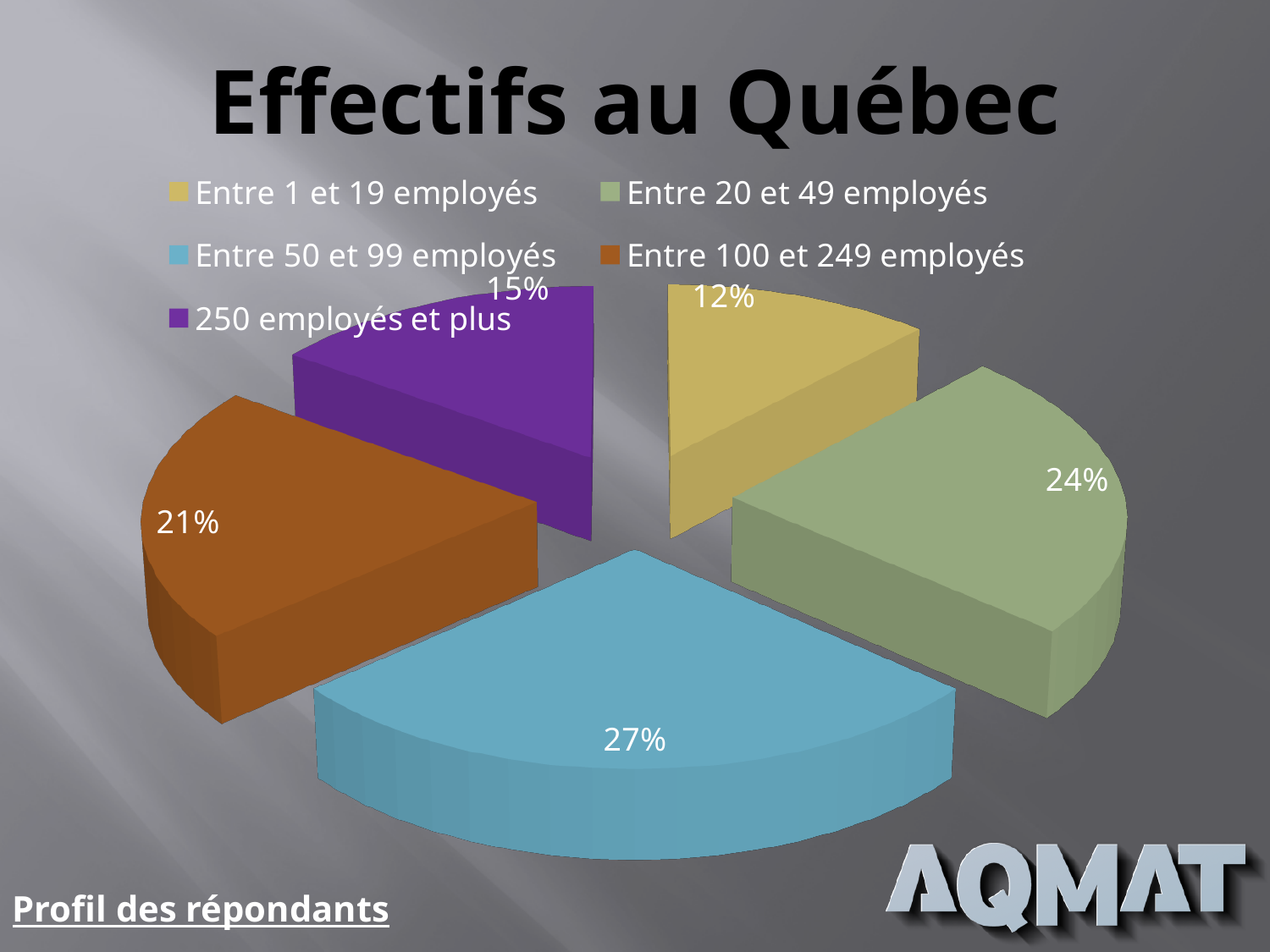
What share of the pie is '250 employés et plus'? 15% What kind of chart is shown on the slide? Pie chart Which category has the largest share of the pie? Entre 50 et 99 employés What share of the pie is 'Entre 50 et 99 employés'? 27% How many categories does the legend list? 5 What is the title of the chart? Effectifs au Québec What share of the pie is 'Entre 20 et 49 employés'? 24% What share of the pie is 'Entre 100 et 249 employés'? 21% Which is larger, the share for 'Entre 100 et 249 employés' or the share for '250 employés et plus'? Entre 100 et 249 employés What is the difference between the shares for 'Entre 50 et 99 employés' and 'Entre 1 et 19 employés'? 15% Which category has the smallest share of the pie? Entre 1 et 19 employés What share of the pie is 'Entre 1 et 19 employés'? 12%